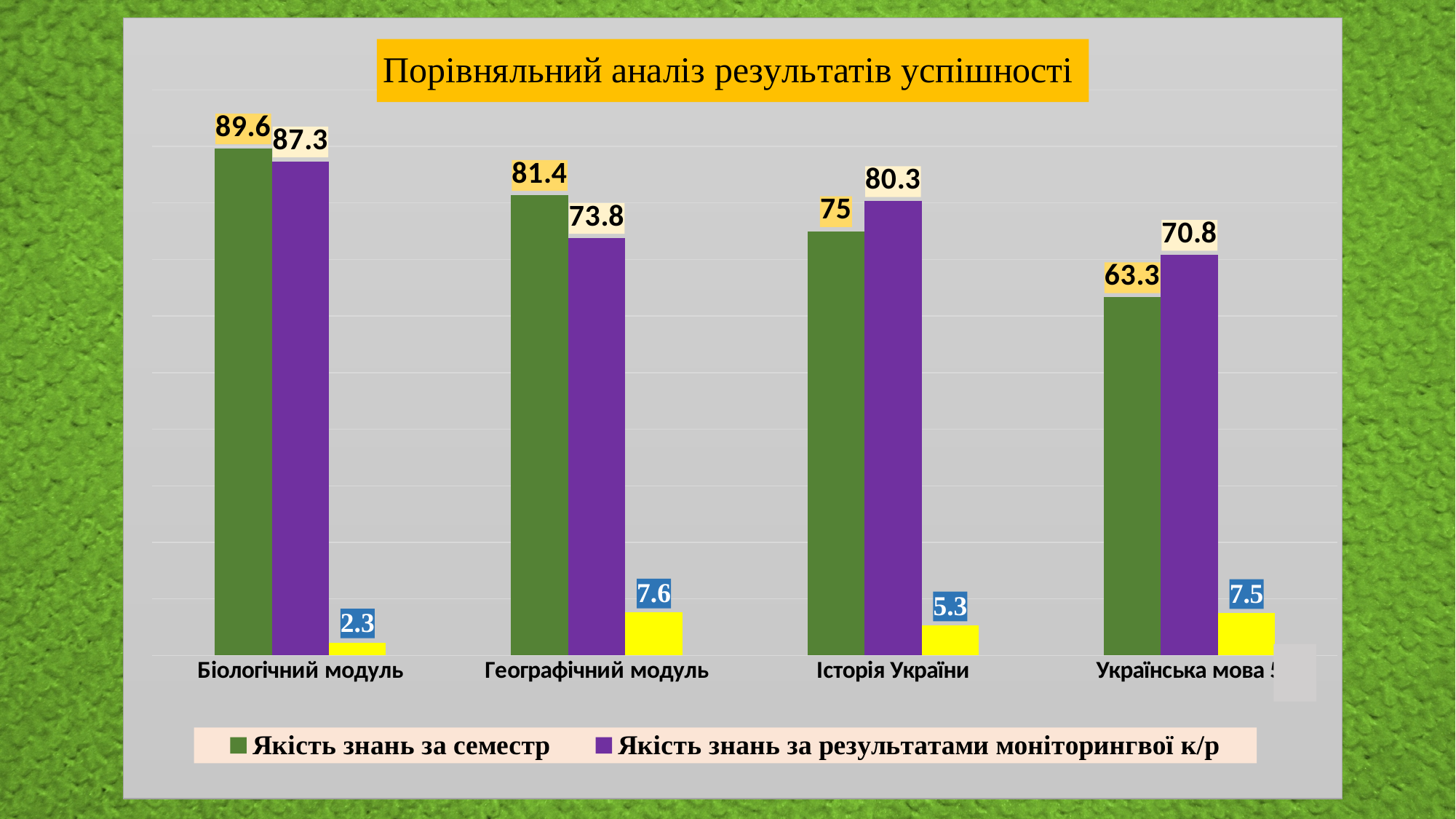
What is the title of the chart? Порівняльний аналіз результатів успішності What is the difference between "Якість знань за семестр" and "Якість знань за результатами моніторингвої к/р" for Географічний модуль? 7.6 What is the value of "Якість знань за результатами моніторингвої к/р" for Історія України? 80.3 Do the values of "Якість знань за семестр" rise or fall from left to right across the categories? Fall Which category has the highest value for "Якість знань за семестр"? Біологічний модуль What value is shown on the small yellow bar for Географічний модуль? 7.6 Which category has the lowest value for "Якість знань за результатами моніторингвої к/р"? Українська мова For Історія України, which is larger: "Якість знань за семестр" or "Якість знань за результатами моніторингвої к/р"? Якість знань за результатами моніторингвої к/р What kind of chart is shown on the slide? Bar chart How many categories are shown on the x axis? 4 How many series does the legend list? 2 What is the value of "Якість знань за семестр" for Біологічний модуль? 89.6